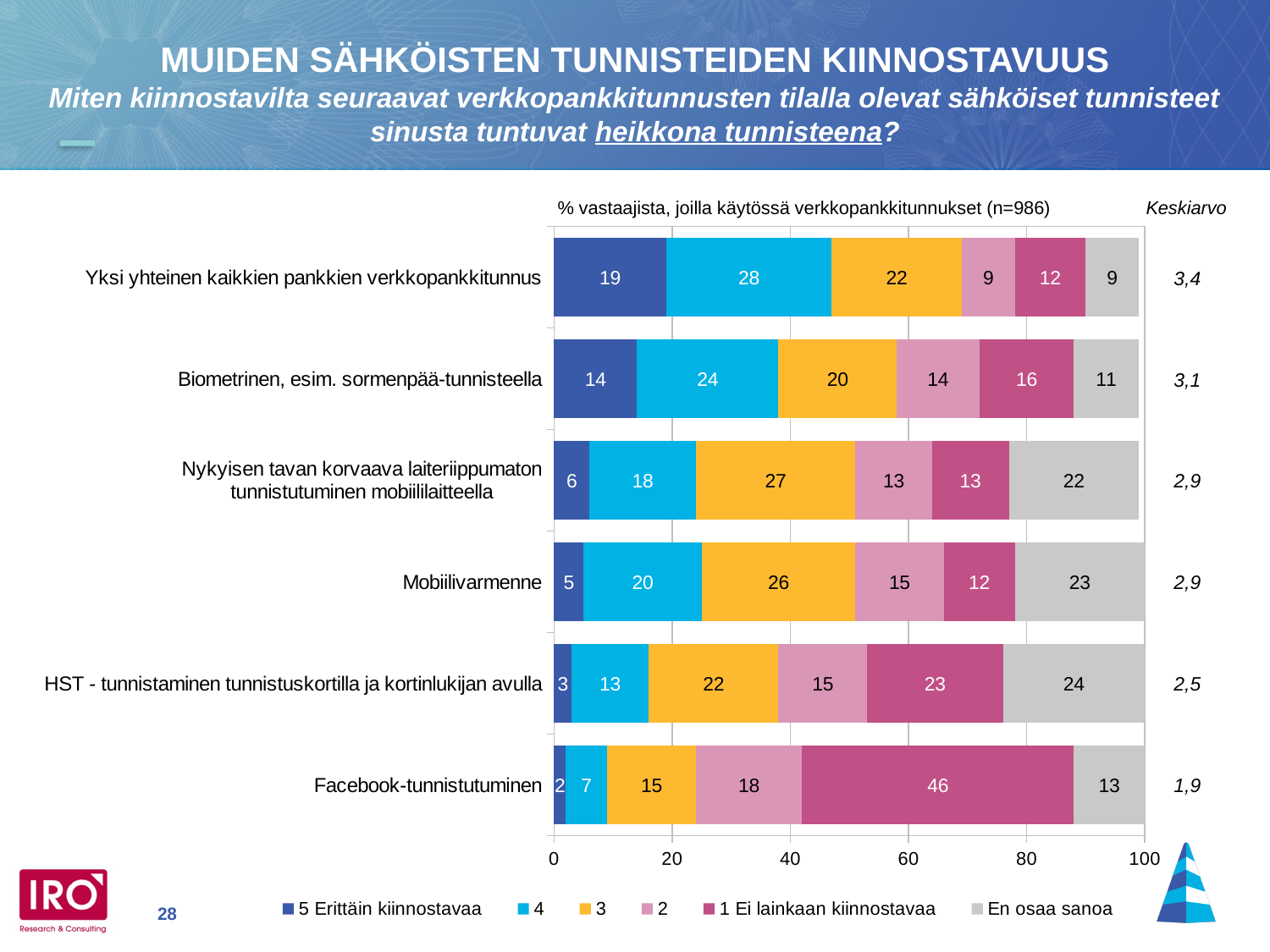
What kind of chart is shown on the slide? Stacked bar chart Which category has the lowest value for '5 Erittäin kiinnostavaa'? Facebook-tunnistutuminen Which has the larger 'En osaa sanoa' value: 'HST - tunnistaminen tunnistuskortilla ja kortinlukijan avulla' or 'Mobiilivarmenne'? HST - tunnistaminen tunnistuskortilla ja kortinlukijan avulla What is the value of '1 Ei lainkaan kiinnostavaa' for 'Facebook-tunnistutuminen'? 46 Which category has the highest value for '5 Erittäin kiinnostavaa'? Yksi yhteinen kaikkien pankkien verkkopankkitunnus What is the total of the stacked bar for 'HST - tunnistaminen tunnistuskortilla ja kortinlukijan avulla'? 100 How many categories (electronic identification methods) are plotted in the chart? 6 What is the value of '5 Erittäin kiinnostavaa' for 'Yksi yhteinen kaikkien pankkien verkkopankkitunnus'? 19 How many series does the legend list? 6 What is the difference between the '4' values for 'Yksi yhteinen kaikkien pankkien verkkopankkitunnus' and 'Biometrinen, esim. sormenpää-tunnisteella'? 4 Which category has the highest Keskiarvo value? Yksi yhteinen kaikkien pankkien verkkopankkitunnus What is the Keskiarvo value shown for 'Biometrinen, esim. sormenpää-tunnisteella'? 3,1